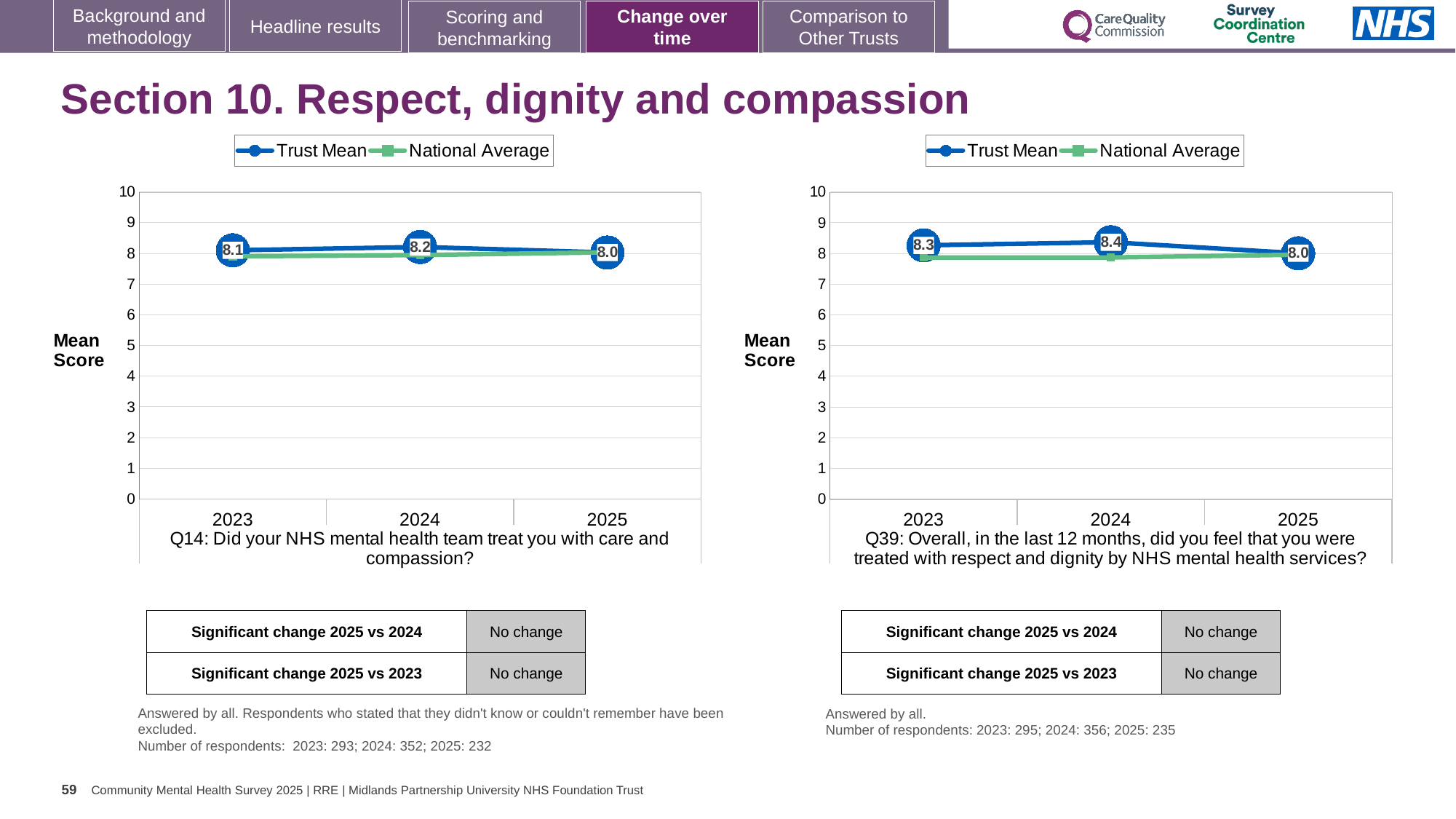
In the Q14 chart on the left, which year has the highest Trust Mean score? 2024 In the Q39 chart on the right, what is the Trust Mean score for 2025? 8.0 In the Q39 chart on the right, what is the difference between the Trust Mean scores for 2024 and 2025? 0.4 What kind of chart is the Q14 chart on the left? Line chart In the Q14 chart on the left, is the Trust Mean score higher in 2023 or in 2025? 2023 In the Q39 chart on the right, which year has the lowest Trust Mean score? 2025 In the Q14 chart on the left, what is the Trust Mean score for 2023? 8.1 How many years are plotted on the x axis of the Q14 chart on the left? 3 How many series does the legend of the Q39 chart on the right list? 2 In the Q39 chart on the right, what is the Trust Mean score for 2024? 8.4 In the Q14 chart on the left, what is the Trust Mean score for 2025? 8.0 In the Q39 chart on the right, is the Trust Mean value for 2024 greater or less than 5? greater